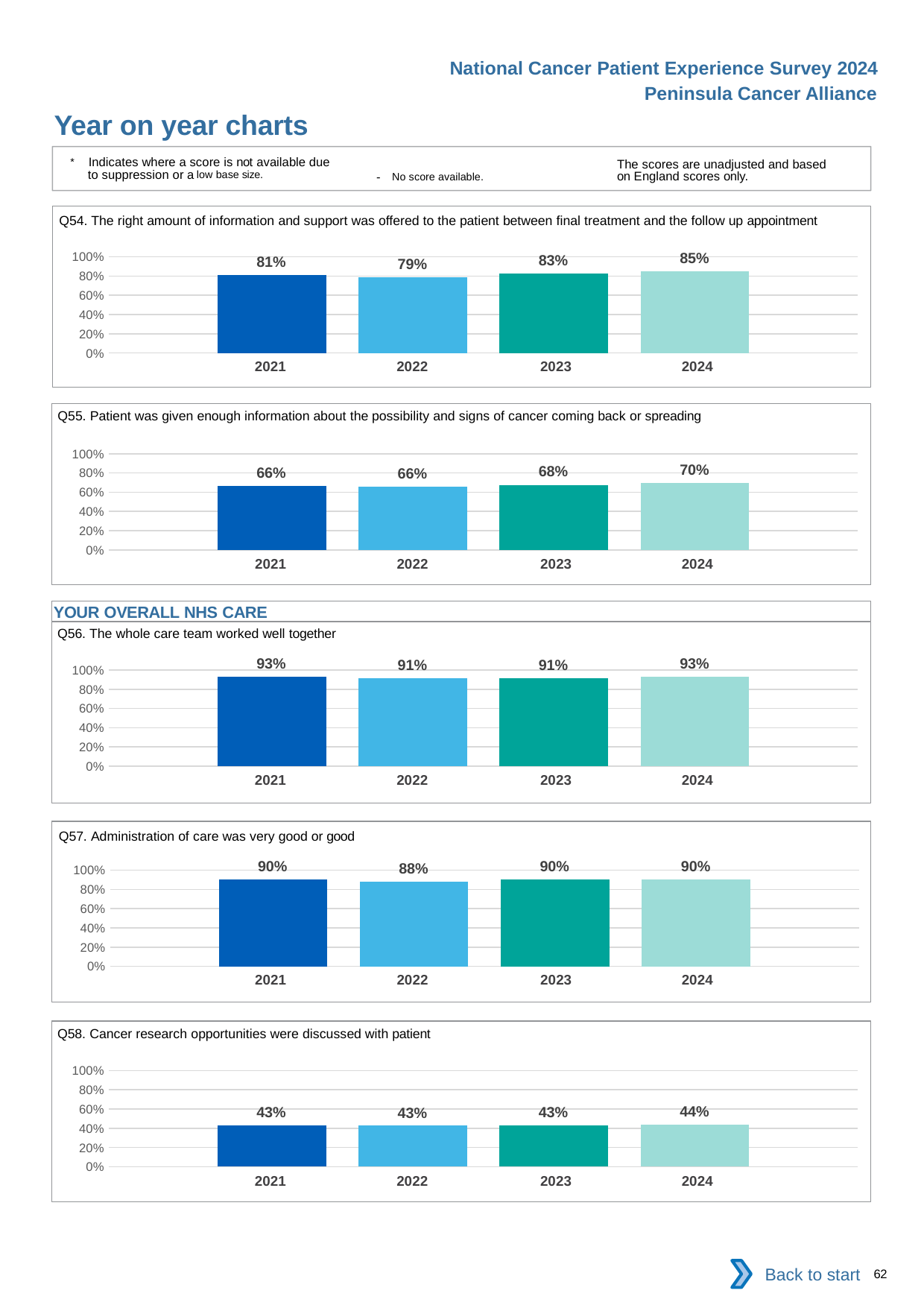
In the Q55 chart, what is the difference between the 2024 and 2021 values? 4 percentage points In the Q56 chart, is the value for 2021 greater or less than 80%? greater In the Q57 chart, which year has the lowest value? 2022 How many years are shown in the Q58 chart? 4 In the Q55 chart, what is the value for 2023? 68% In the Q58 chart, is the value for 2021 greater or less than 60%? less In the Q54 chart, which year has the lowest value? 2022 In the Q58 chart, what is the value for 2024? 44% In the Q56 chart, what is the value for 2022? 91% In the Q57 chart, what is the difference between the 2023 and 2022 values? 2 percentage points In the Q54 chart, what is the value for 2024? 85% What type of chart is the Q54 chart? Bar chart